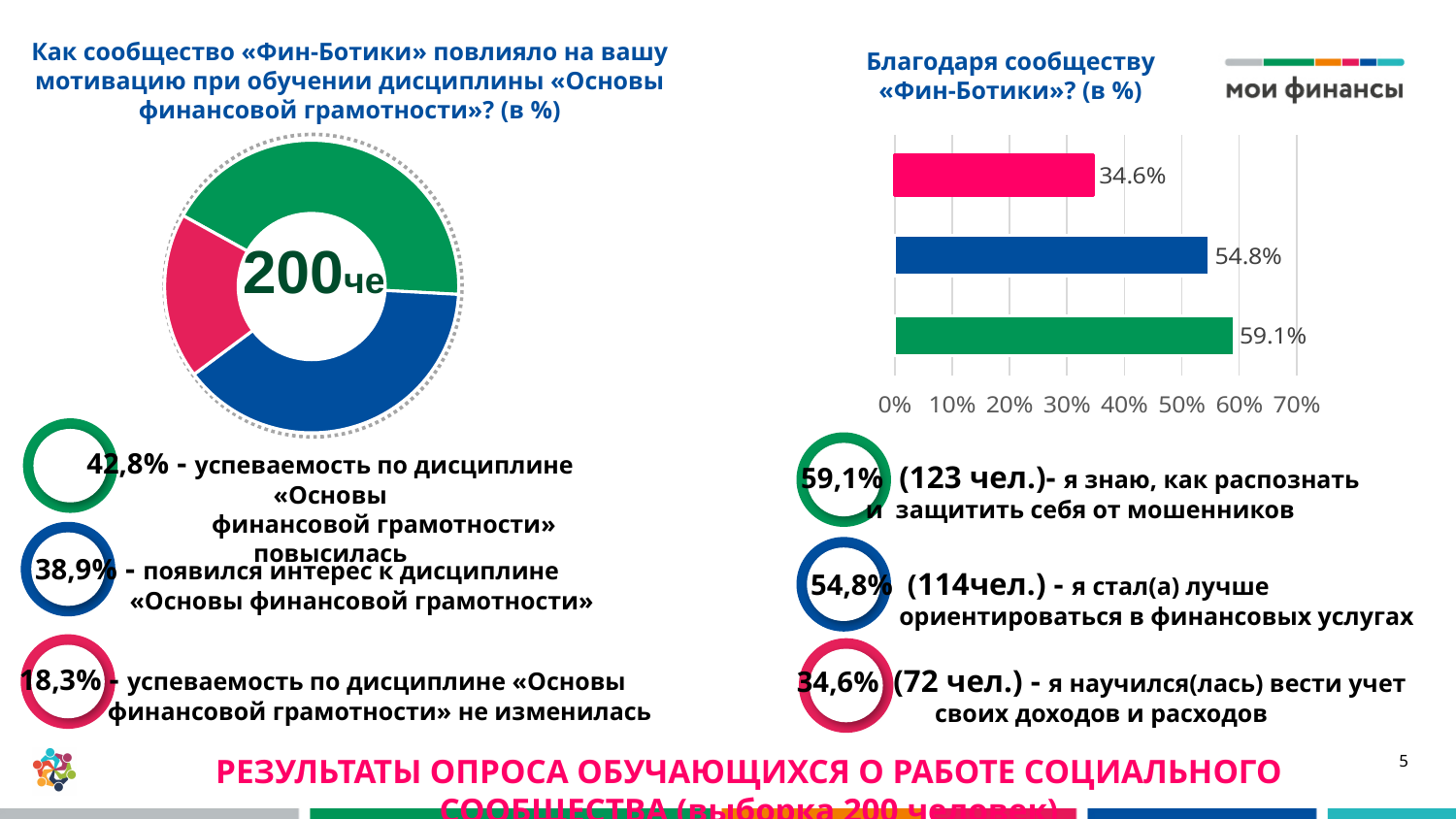
In the bar chart on the right, what is the value of the blue bar (я стал(а) лучше ориентироваться в финансовых услугах)? 54.8% In the bar chart on the right, how many bars are plotted? 3 What kind of chart is the chart on the right titled «Благодаря сообществу «Фин-Ботики»? (в %)»? bar chart In the bar chart on the right, what is the value of the pink bar (я научился(лась) вести учет своих доходов и расходов)? 34.6% In the bar chart on the right, what is the value of the green bar (я знаю, как распознать и защитить себя от мошенников)? 59.1% In the bar chart on the right, which bar has the highest value? the green bar, 59.1% In the bar chart on the right, what is the highest value shown on the horizontal axis? 70% In the bar chart on the right, which bar has the lowest value? the pink bar, 34.6% In the donut chart on the left, what share corresponds to «успеваемость по дисциплине «Основы финансовой грамотности» повысилась» (green)? 42,8% What kind of chart is the chart on the left under the title «Как сообщество «Фин-Ботики» повлияло на вашу мотивацию...»? donut chart In the bar chart on the right, what is the difference between the green bar (59.1%) and the pink bar (34.6%)? 24.5% In the donut chart on the left, what number is printed in the centre of the donut? 200